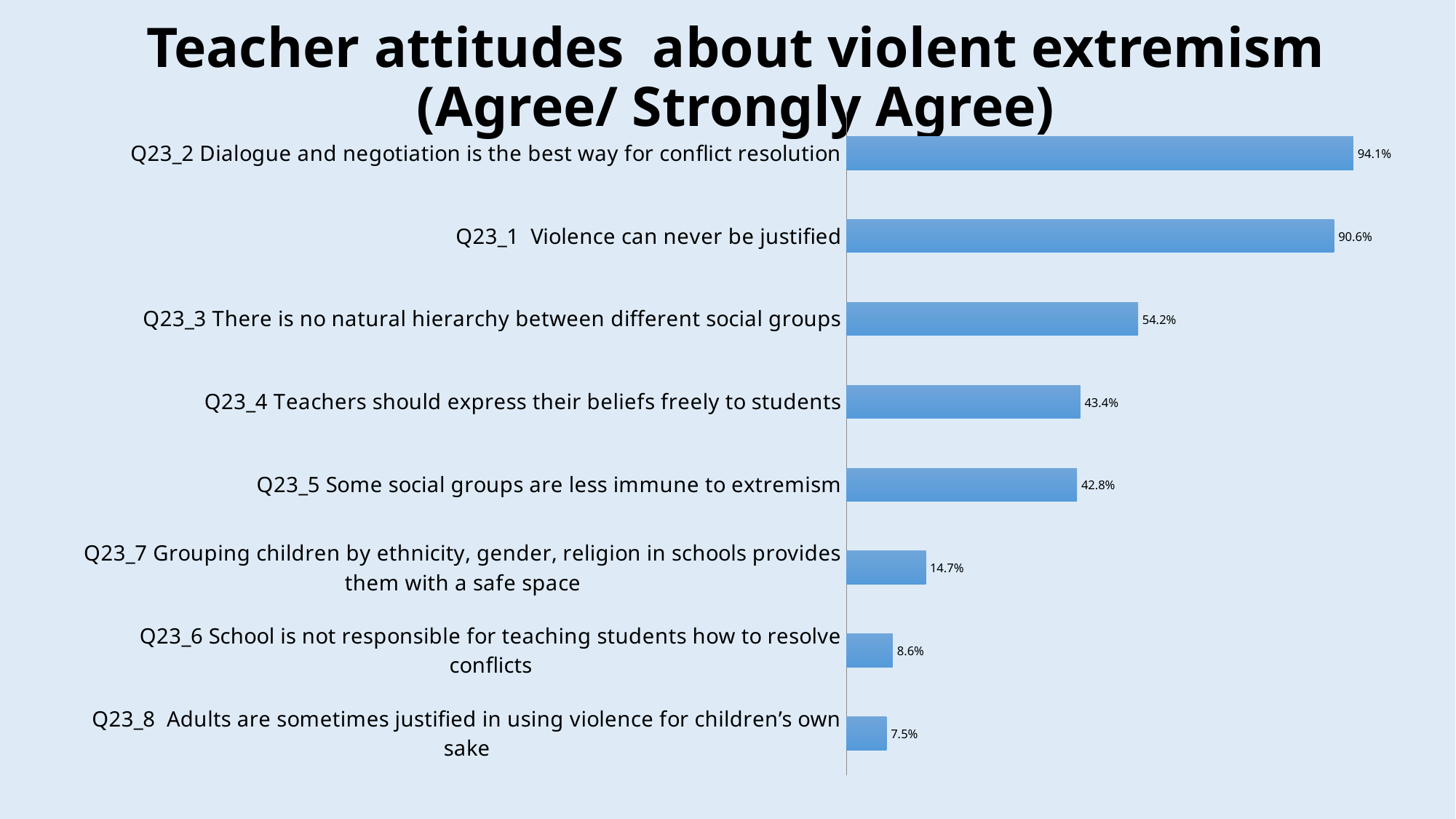
What is the value shown for Q23_1 'Violence can never be justified'? 90.6% What is the title of the chart? Teacher attitudes about violent extremism (Agree/ Strongly Agree) What is the difference between the values for Q23_2 and Q23_1? 3.5% Which has a larger value, Q23_3 'There is no natural hierarchy between different social groups' or Q23_5 'Some social groups are less immune to extremism'? Q23_3 Which statement has the lowest agreement percentage? Q23_8 Adults are sometimes justified in using violence for children's own sake Which has a larger value, Q23_6 'School is not responsible for teaching students how to resolve conflicts' or Q23_7 'Grouping children by ethnicity, gender, religion in schools provides them with a safe space'? Q23_7 What percentage of teachers agree or strongly agree that dialogue and negotiation is the best way for conflict resolution (Q23_2)? 94.1% How many statements (bars) are shown in the chart? 8 What is the difference between the values for Q23_3 and Q23_4? 10.8% Which statement has the highest agreement percentage? Q23_2 Dialogue and negotiation is the best way for conflict resolution What is the value for Q23_7 'Grouping children by ethnicity, gender, religion in schools provides them with a safe space'? 14.7% What type of chart is shown on the slide? Bar chart